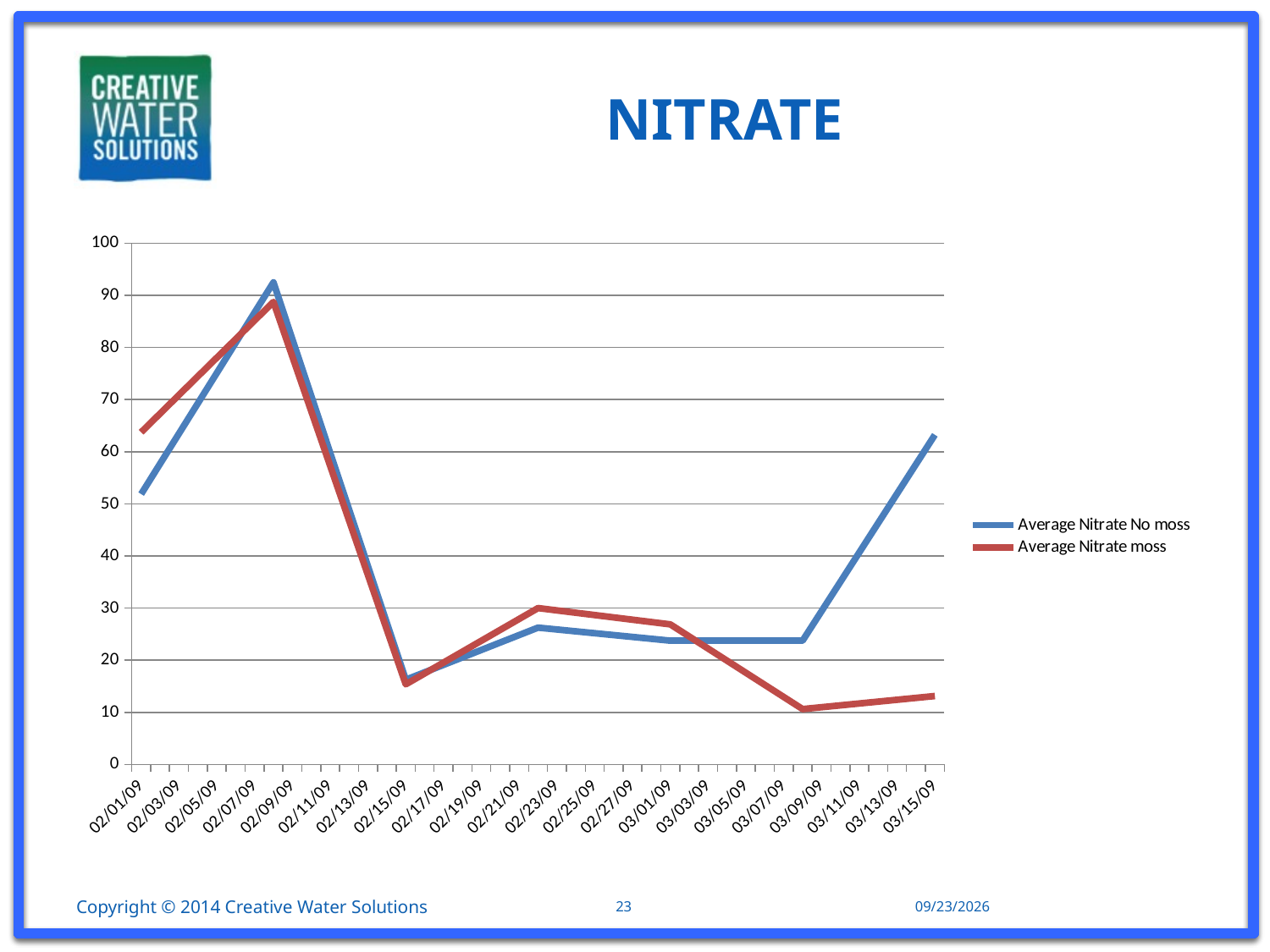
Does the Average Nitrate moss series rise or fall between 03/01/09 and 03/07/09? fall What kind of chart is shown on the slide? line chart Which series is drawn in red? Average Nitrate moss How many series does the legend list? 2 What is the title of the chart? NITRATE On 02/01/09, which series has the larger value, Average Nitrate No moss or Average Nitrate moss? Average Nitrate moss Is the value for Average Nitrate moss on 02/01/09 greater or less than 60? greater Is the value for Average Nitrate No moss on 03/15/09 greater or less than 60? greater Is the value for Average Nitrate moss on 03/07/09 greater or less than 20? less On 03/15/09, which series has the larger value, Average Nitrate No moss or Average Nitrate moss? Average Nitrate No moss